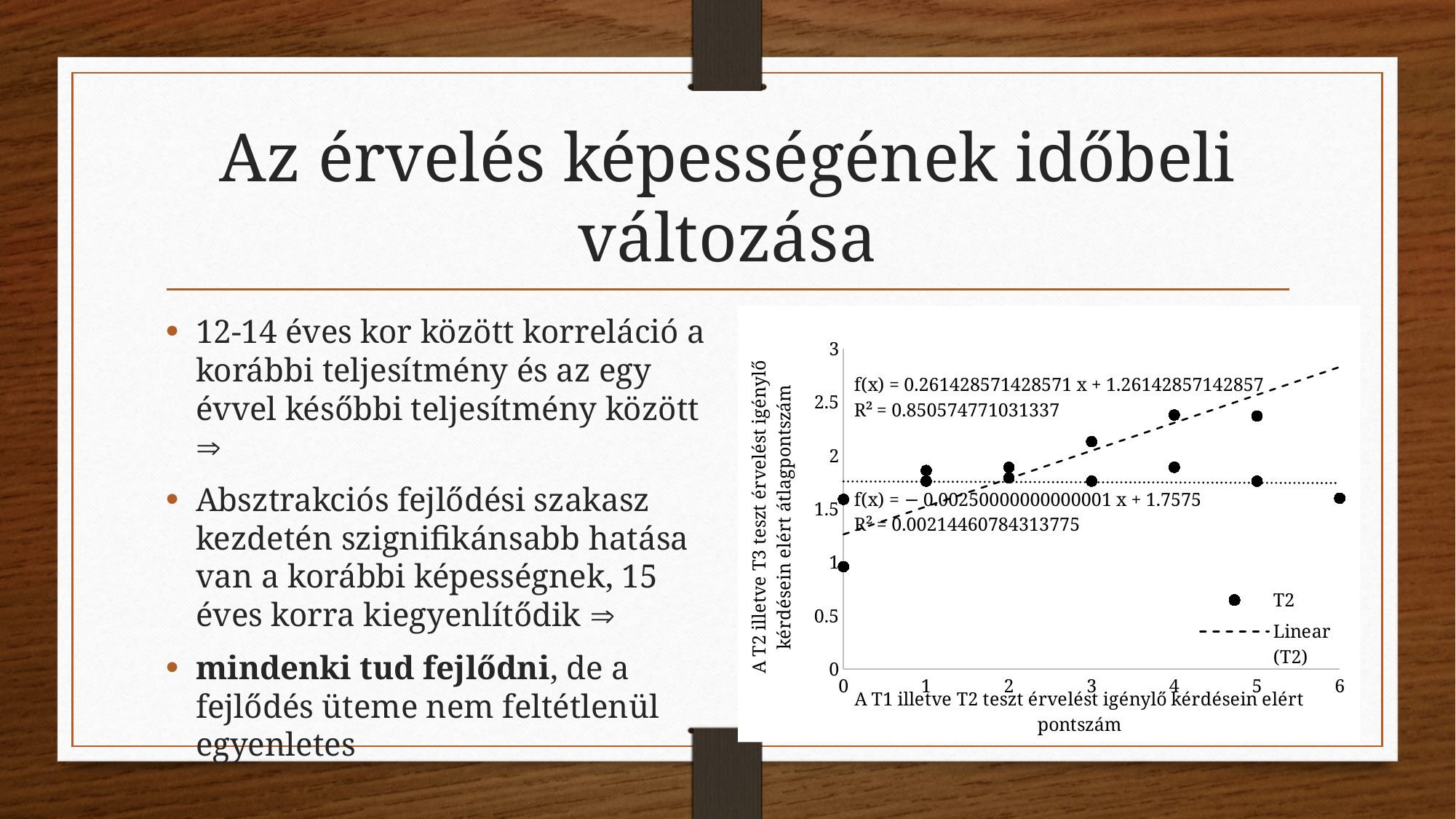
What is the R² value printed for the rising dashed trendline? 0.850574771031337 What is the equation printed for the rising dashed trendline? f(x) = 0.261428571428571 x + 1.26142857142857 Which of the two R² values printed on the chart is larger, the one for the dashed trendline or the one for the dotted trendline? the dashed trendline Is the plotted point at x = 6 greater or less than 2? less What is the R² value printed for the nearly flat dotted trendline? 0.00214460784313775 What is the equation printed for the nearly flat dotted trendline? f(x) = −0.00250000000000001 x + 1.7575 What are the two entries in the chart legend? T2 and Linear (T2) What kind of chart is shown on the slide? scatter chart How many entries does the chart legend list? 2 What is the highest value shown on the y axis? 3 Is the highest plotted point at x = 4 greater or less than 2? greater Does the dashed trendline rise or fall as x increases? rise